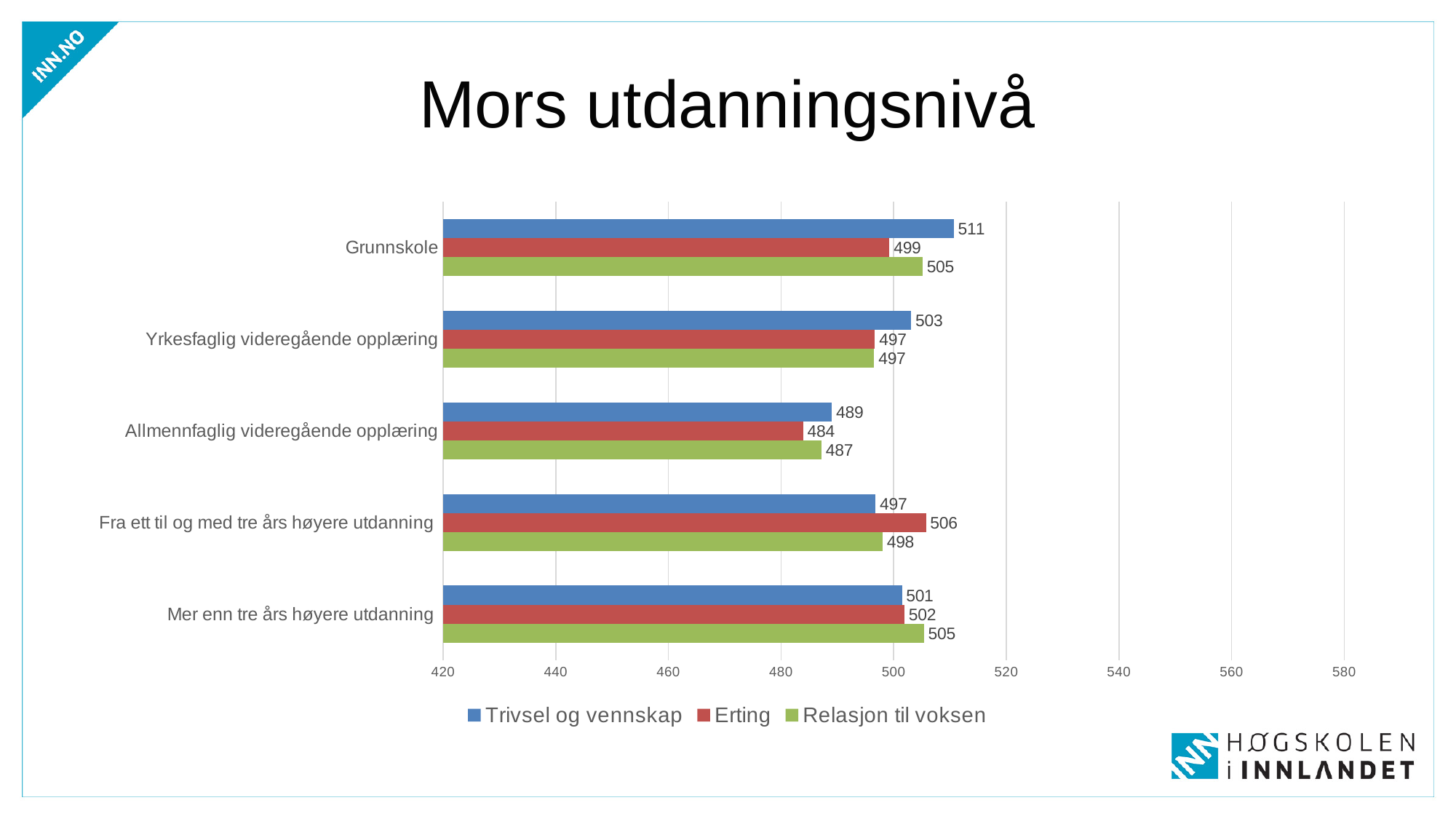
Which category has the lowest value for Erting? Allmennfaglig videregående opplæring Which is larger for Fra ett til og med tre års høyere utdanning: Trivsel og vennskap or Erting? Erting How many categories are shown on the y axis? 5 What kind of chart is shown on the slide? bar chart What is the difference between the Trivsel og vennskap values for Grunnskole and Allmennfaglig videregående opplæring? 22 Is the value of Erting for Allmennfaglig videregående opplæring greater or less than 500? less Which category has the highest value for Trivsel og vennskap? Grunnskole What is the value of Relasjon til voksen for Allmennfaglig videregående opplæring? 487 What is the title of the chart? Mors utdanningsnivå How many series does the legend list? 3 What is the value of Erting for Fra ett til og med tre års høyere utdanning? 506 What is the value of Trivsel og vennskap for Grunnskole? 511